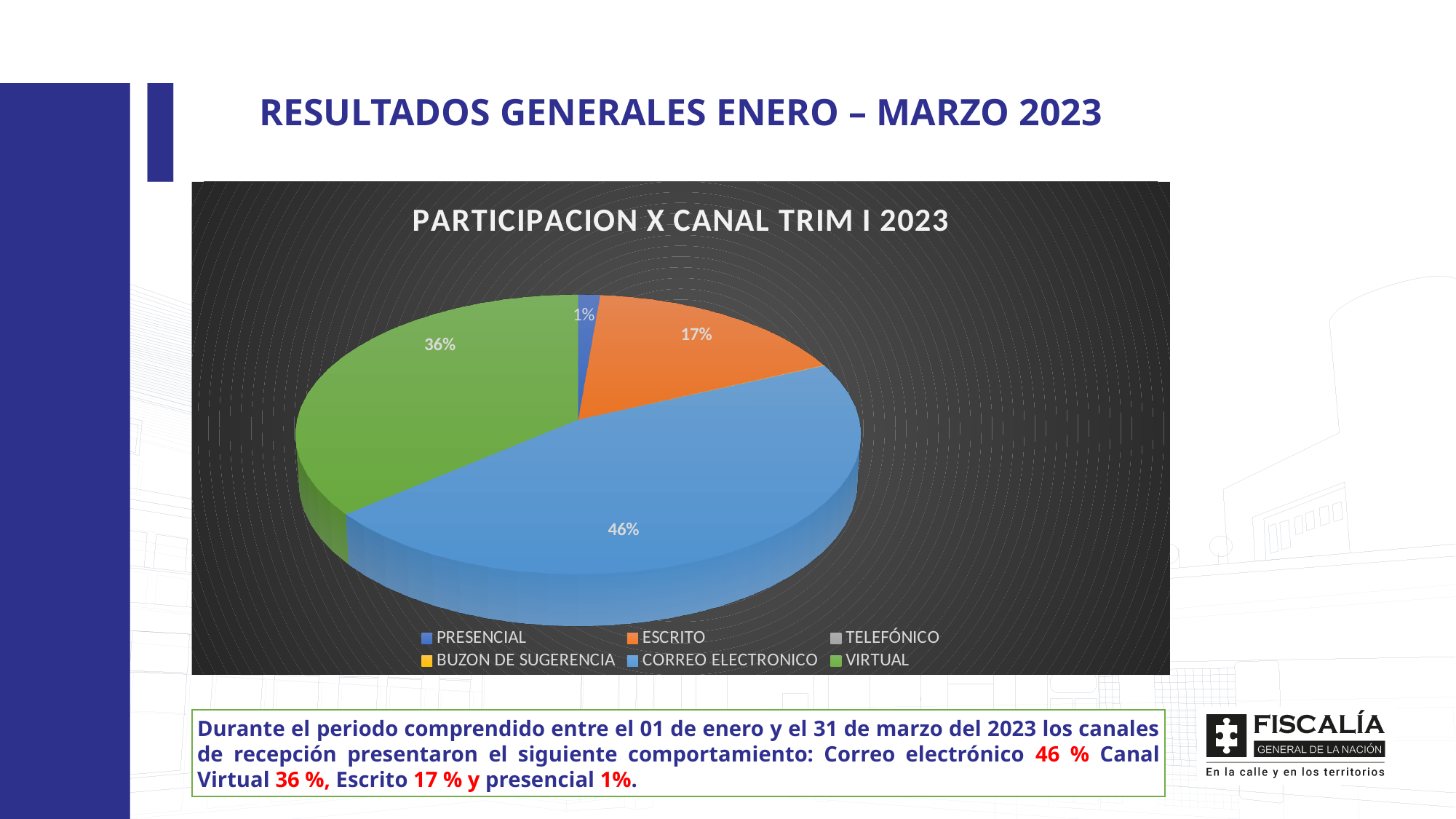
Which has a larger share, ESCRITO or VIRTUAL? VIRTUAL What is the title of the chart? PARTICIPACION X CANAL TRIM I 2023 What percentage share does CORREO ELECTRONICO have in the pie chart? 46% What type of chart is shown on the slide? Pie chart What percentage share does ESCRITO have in the pie chart? 17% What percentage share does VIRTUAL have in the pie chart? 36% What colour represents VIRTUAL in the pie chart? Green How many entries does the chart legend list? 6 What percentage share does PRESENCIAL have in the pie chart? 1% Which channel has the largest share of the pie? CORREO ELECTRONICO Which labelled channel has the smallest share of the pie? PRESENCIAL What is the difference in percentage points between the CORREO ELECTRONICO and VIRTUAL shares? 10